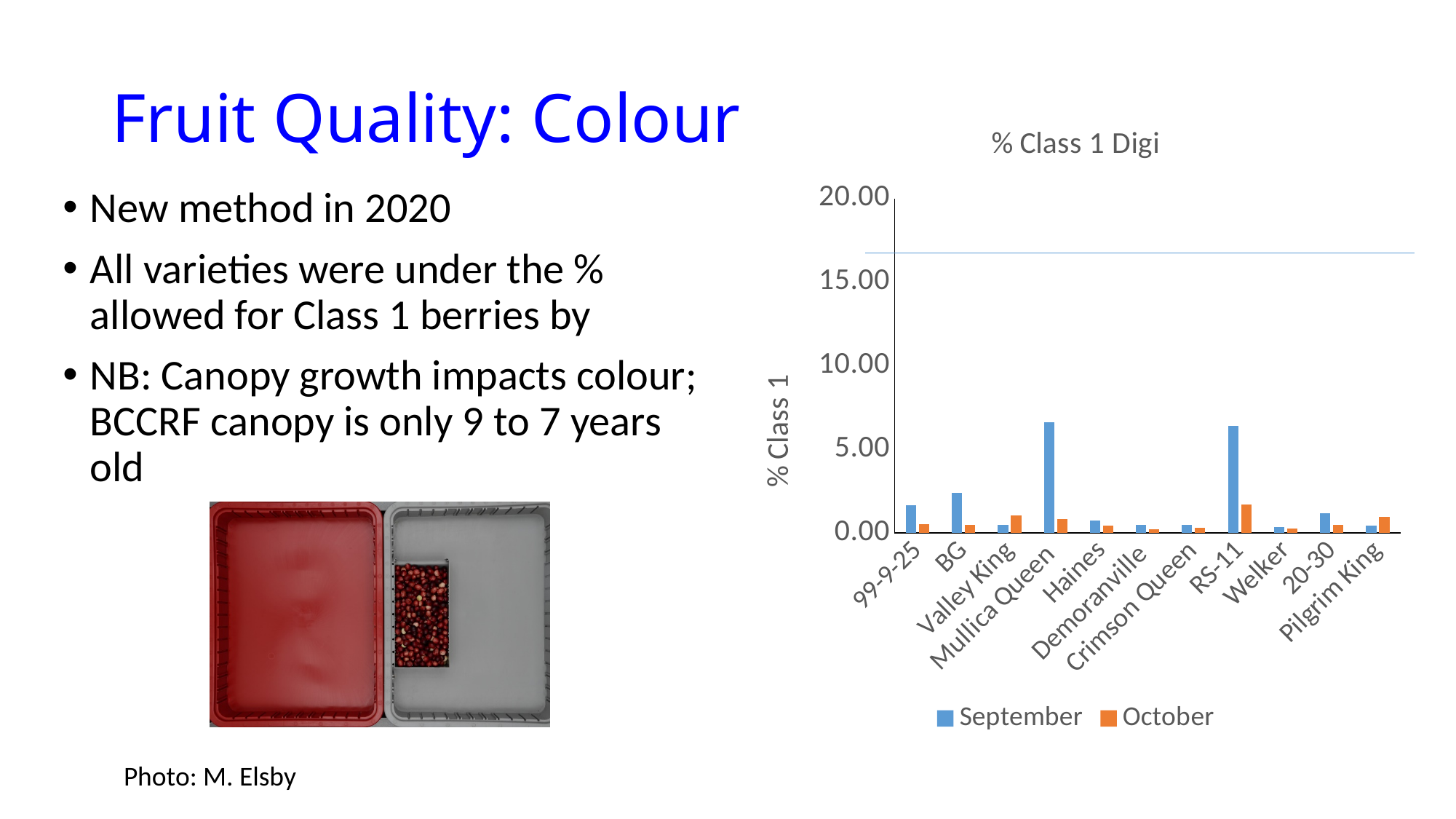
How many series does the chart's legend list? 2 How many varieties (categories) are shown on the x axis of the chart? 11 Is the September value for Mullica Queen greater or less than 5.00? greater Which is larger for Valley King: the September value or the October value? October What is the title of the chart? % Class 1 Digi Which has the larger September value: Mullica Queen or Haines? Mullica Queen Is the September value for RS-11 greater or less than 5.00? greater Which series is shown in orange in the chart? October Which is larger for 99-9-25: the September value or the October value? September What kind of chart is shown on the slide? bar chart Is the October value for RS-11 greater or less than 5.00? less